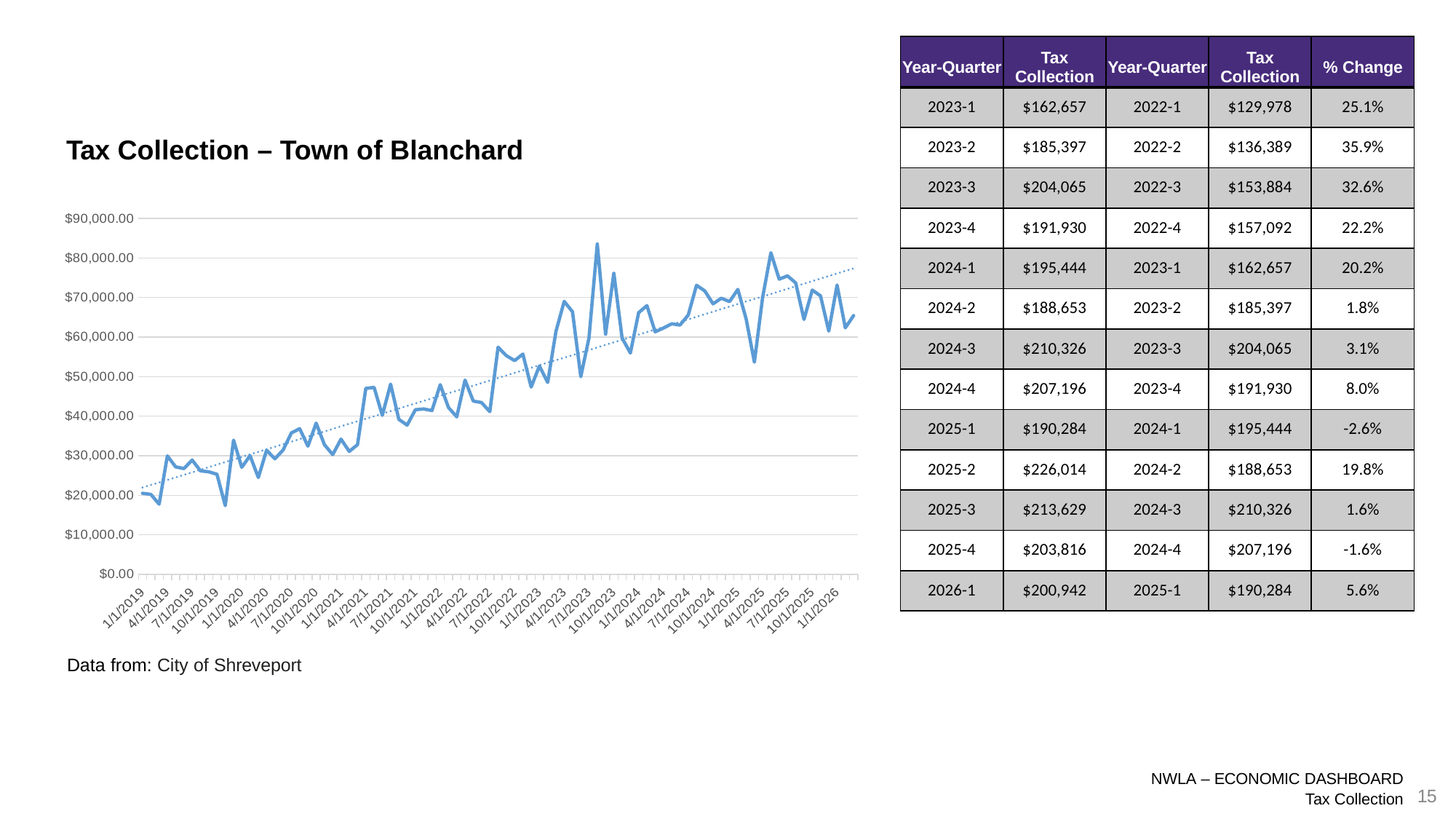
What is the highest value shown on the chart's y axis? $90,000.00 Is the value at 1/1/2024 greater or less than $50,000.00? greater Do the tax collection values generally rise or fall from 2019 to 2026 along the x axis? rise Is the value at 4/1/2025 greater or less than $60,000.00? greater Is the value at 10/1/2022 greater or less than $70,000.00? less What is the title of the chart? Tax Collection – Town of Blanchard Which is larger, the value at 1/1/2019 or the value at 1/1/2025? 1/1/2025 What kind of chart is shown on the slide? line chart